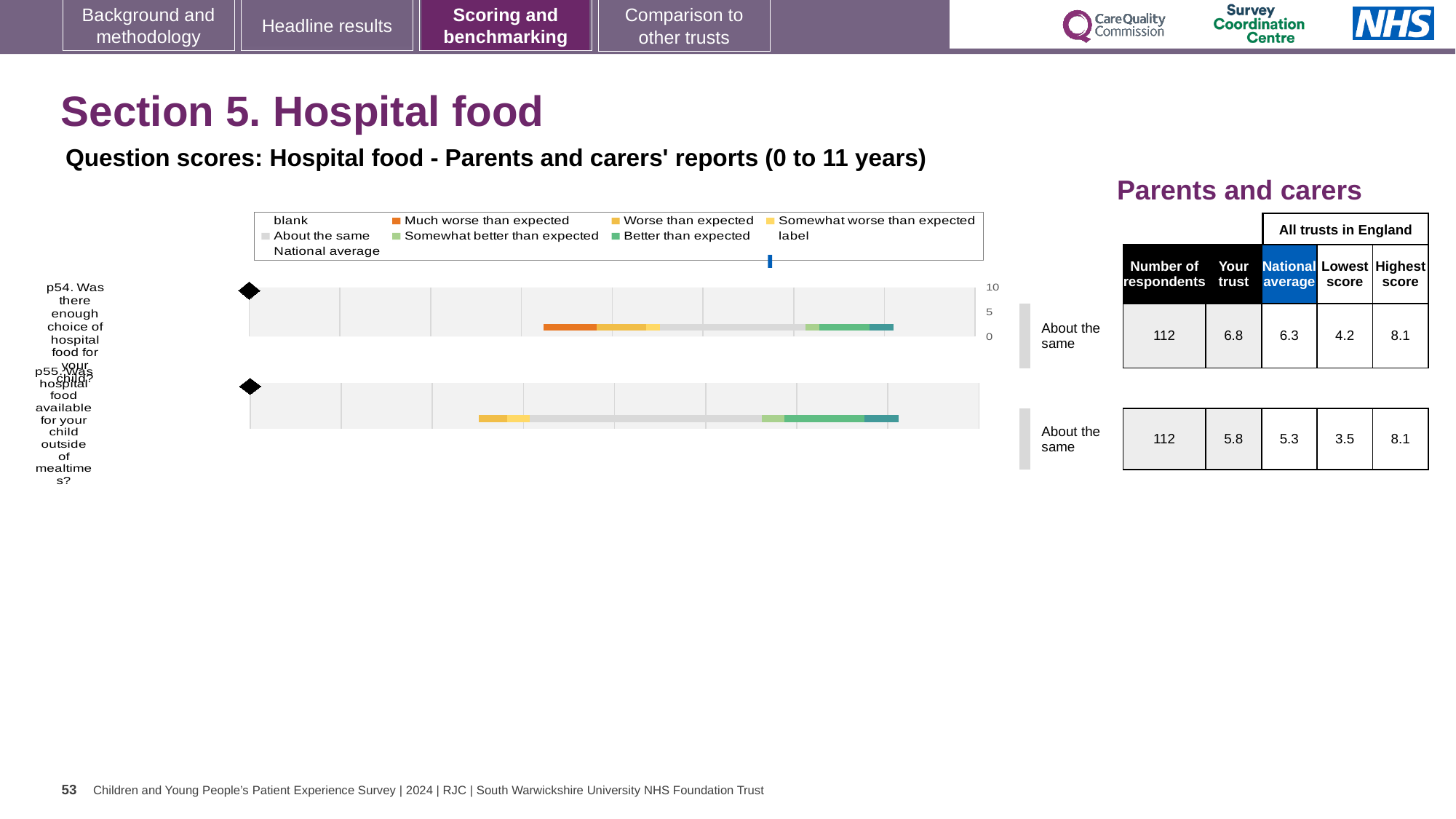
Which question has the higher 'Your trust' score in the table, p54 or p55? p54 What is the highest value shown on the chart's axis? 10 How many questions (bars) are plotted in the chart? 2 What kind of chart is shown on the slide? bar chart What benchmark category is shown next to the bar for p54? About the same What benchmark category is shown next to the bar for p55? About the same In the table beside the chart, what is the 'Your trust' score for p54 (enough choice of hospital food)? 6.8 In the table beside the chart, what is the lowest score for p55? 3.5 Which legend entry is shown in orange? Much worse than expected What is the difference between the 'Your trust' score and the national average for p55? 0.5 In the table beside the chart, what is the 'Your trust' score for p55 (hospital food available outside of mealtimes)? 5.8 In the table beside the chart, what is the national average for p54? 6.3